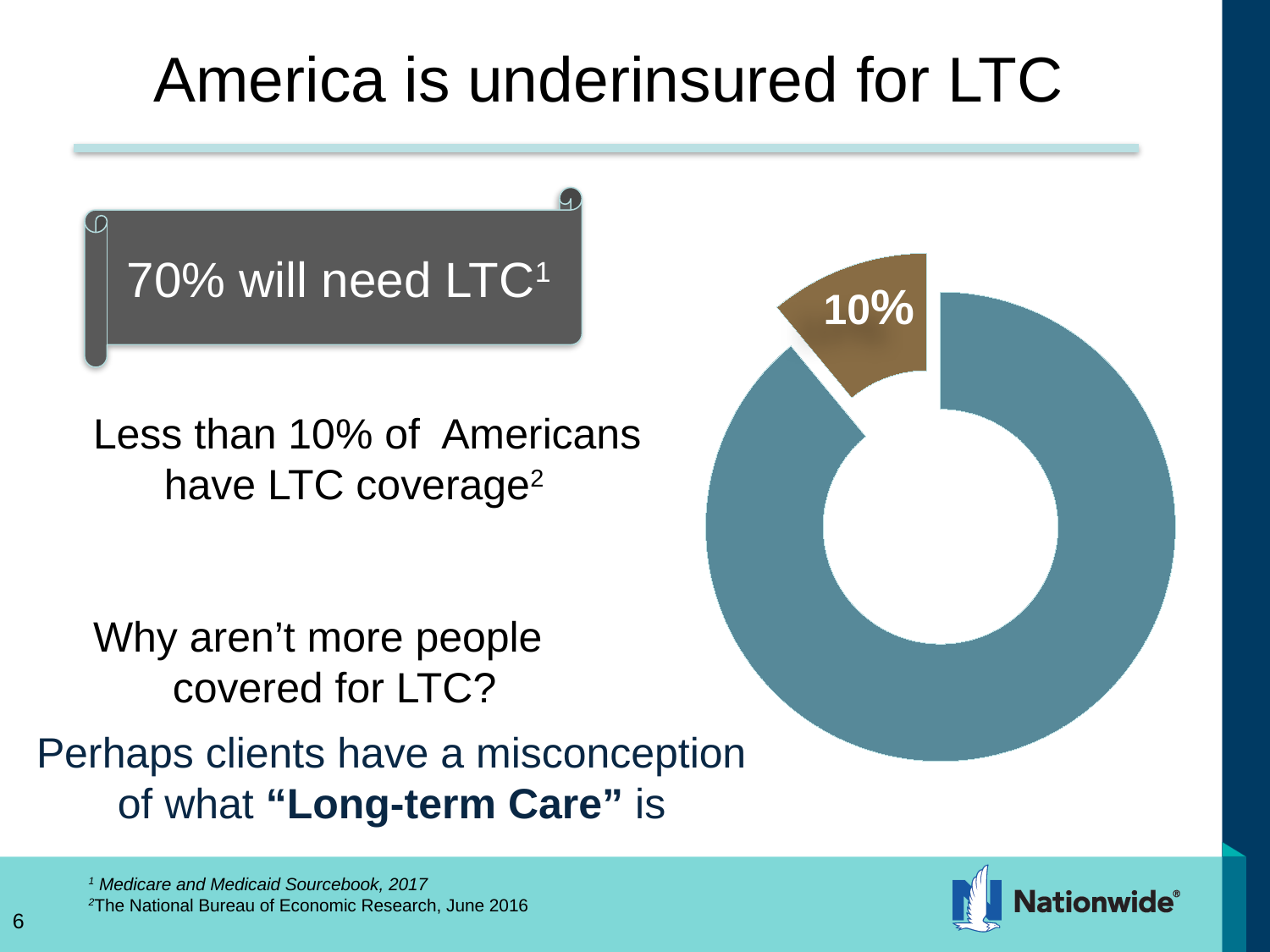
What colour is the slice labeled 10% in the doughnut chart? brown Which slice of the doughnut chart is the smallest? the brown slice labeled 10% How many slices does the doughnut chart have? 2 Is the teal slice of the doughnut chart greater or less than 50% of the whole? greater Is the 10% slice pulled out (exploded) from the rest of the doughnut chart? yes What kind of chart is shown on the right side of the slide? doughnut chart What value is printed on the small exploded slice of the doughnut chart? 10% Which slice of the doughnut chart is larger, the teal slice or the brown slice? the teal slice What share of the doughnut chart does the brown slice represent? 10%